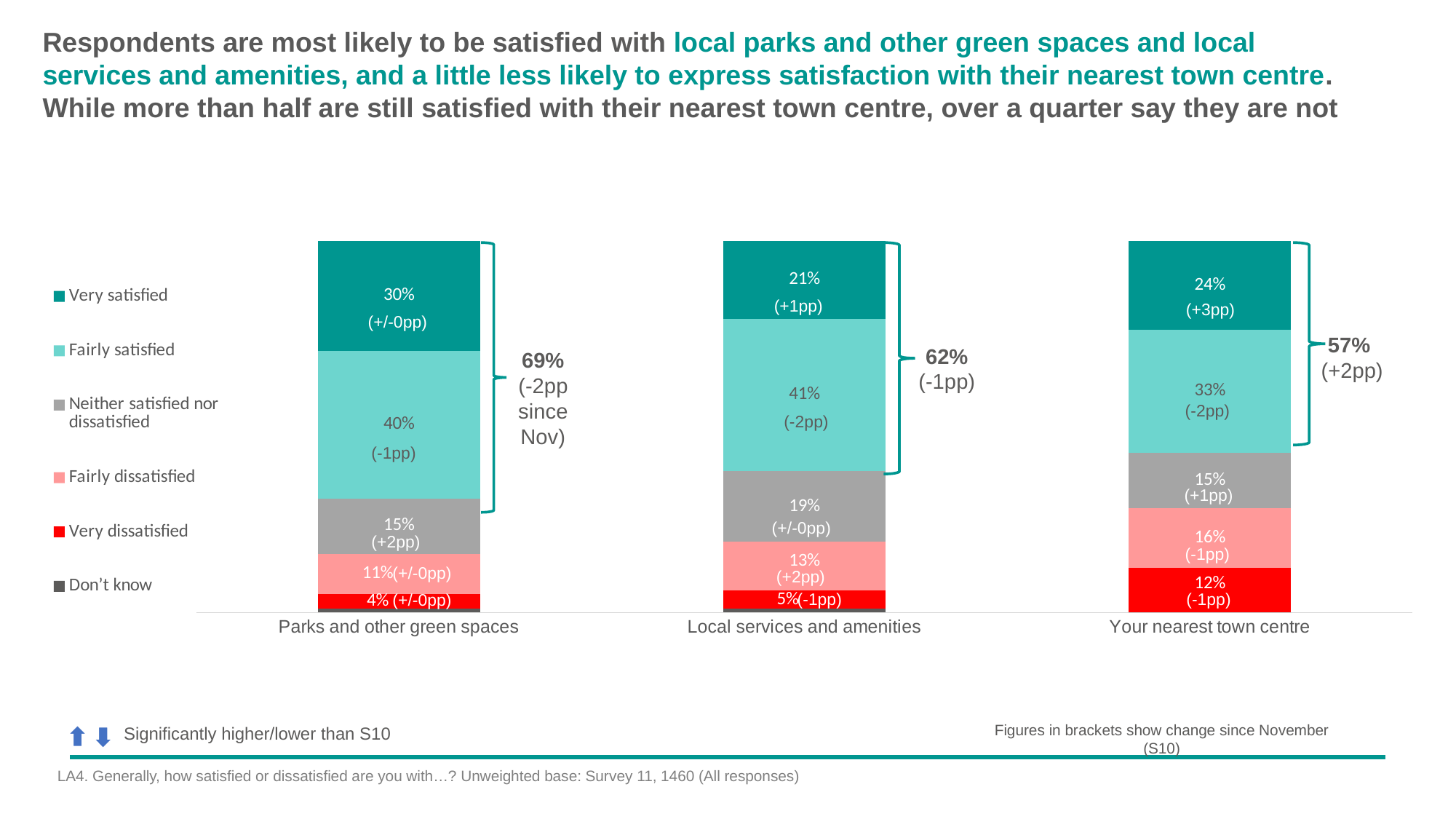
How many series does the legend list? 6 What is the difference between the fairly satisfied percentages for parks and other green spaces and your nearest town centre? 7% What is the combined satisfied (very plus fairly satisfied) figure shown for local services and amenities? 62% What kind of chart is shown on the slide? Stacked bar chart Which category has the highest combined satisfied percentage? Parks and other green spaces What percentage of respondents are very satisfied with parks and other green spaces? 30% How many categories are shown on the x axis of the chart? 3 Is the very satisfied percentage higher for parks and other green spaces or for local services and amenities? Parks and other green spaces What percentage of respondents are fairly satisfied with local services and amenities? 41% What change since November is shown for the combined satisfied figure for your nearest town centre? +2pp What percentage of respondents are very dissatisfied with their nearest town centre? 12% Which category has the lowest percentage of respondents who are very dissatisfied? Parks and other green spaces